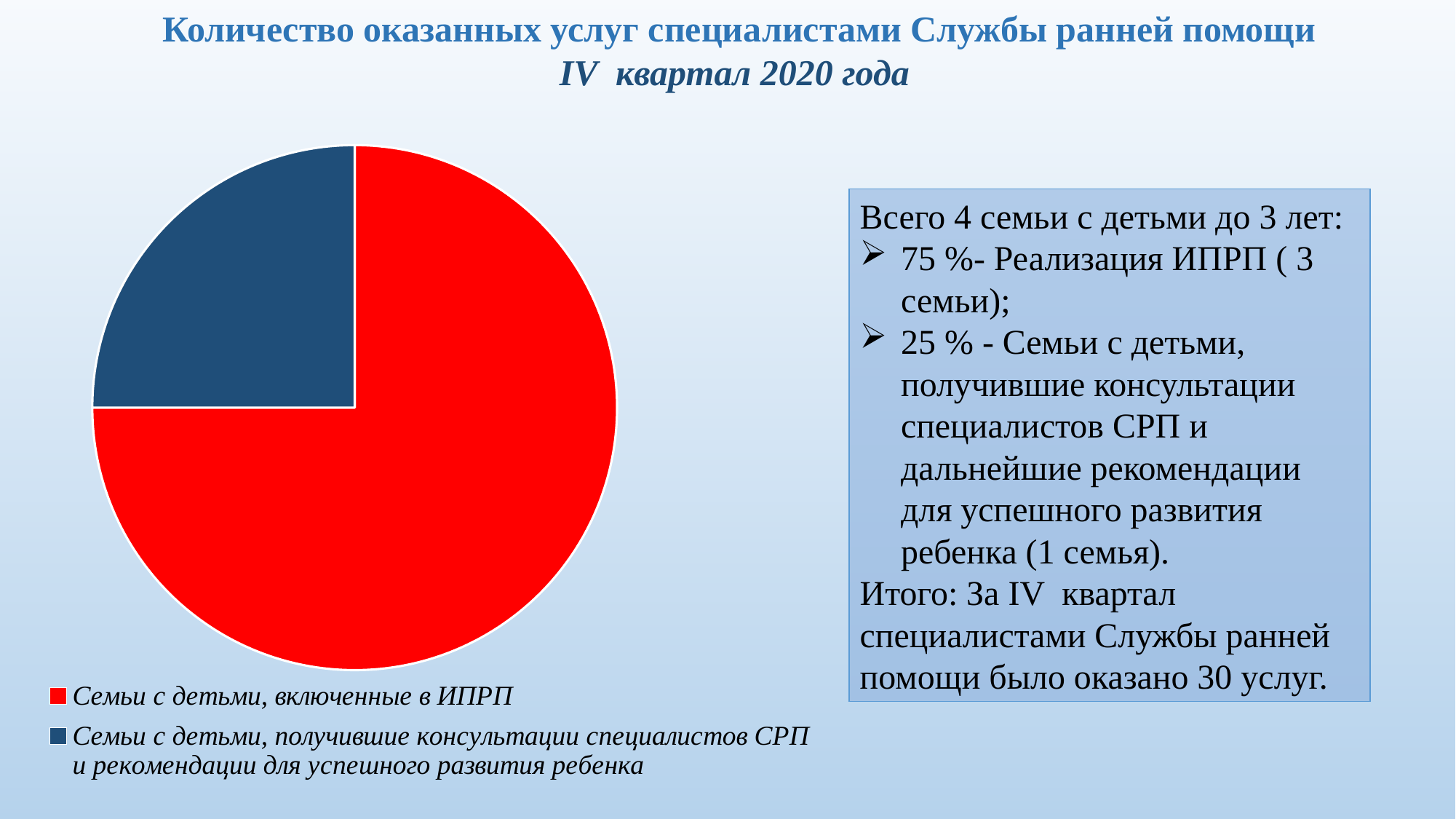
What share of the pie does the slice 'Семьи с детьми, получившие консультации специалистов СРП и рекомендации для успешного развития ребенка' represent, according to the slide? 25 % How many entries does the legend of the pie chart list? 2 Which is larger in the pie chart: the slice for 'Семьи с детьми, включенные в ИПРП' or the slice for 'Семьи с детьми, получившие консультации специалистов СРП и рекомендации для успешного развития ребенка'? Семьи с детьми, включенные в ИПРП What kind of chart is shown on the slide? pie chart How many slices does the pie chart have? 2 Which slice of the pie chart is the largest? Семьи с детьми, включенные в ИПРП What share of the pie does the slice 'Семьи с детьми, включенные в ИПРП' represent, according to the slide? 75 % What colour is the slice for 'Семьи с детьми, получившие консультации специалистов СРП и рекомендации для успешного развития ребенка' in the pie chart? dark blue What colour is the slice for 'Семьи с детьми, включенные в ИПРП' in the pie chart? red Which slice of the pie chart is the smallest? Семьи с детьми, получившие консультации специалистов СРП и рекомендации для успешного развития ребенка